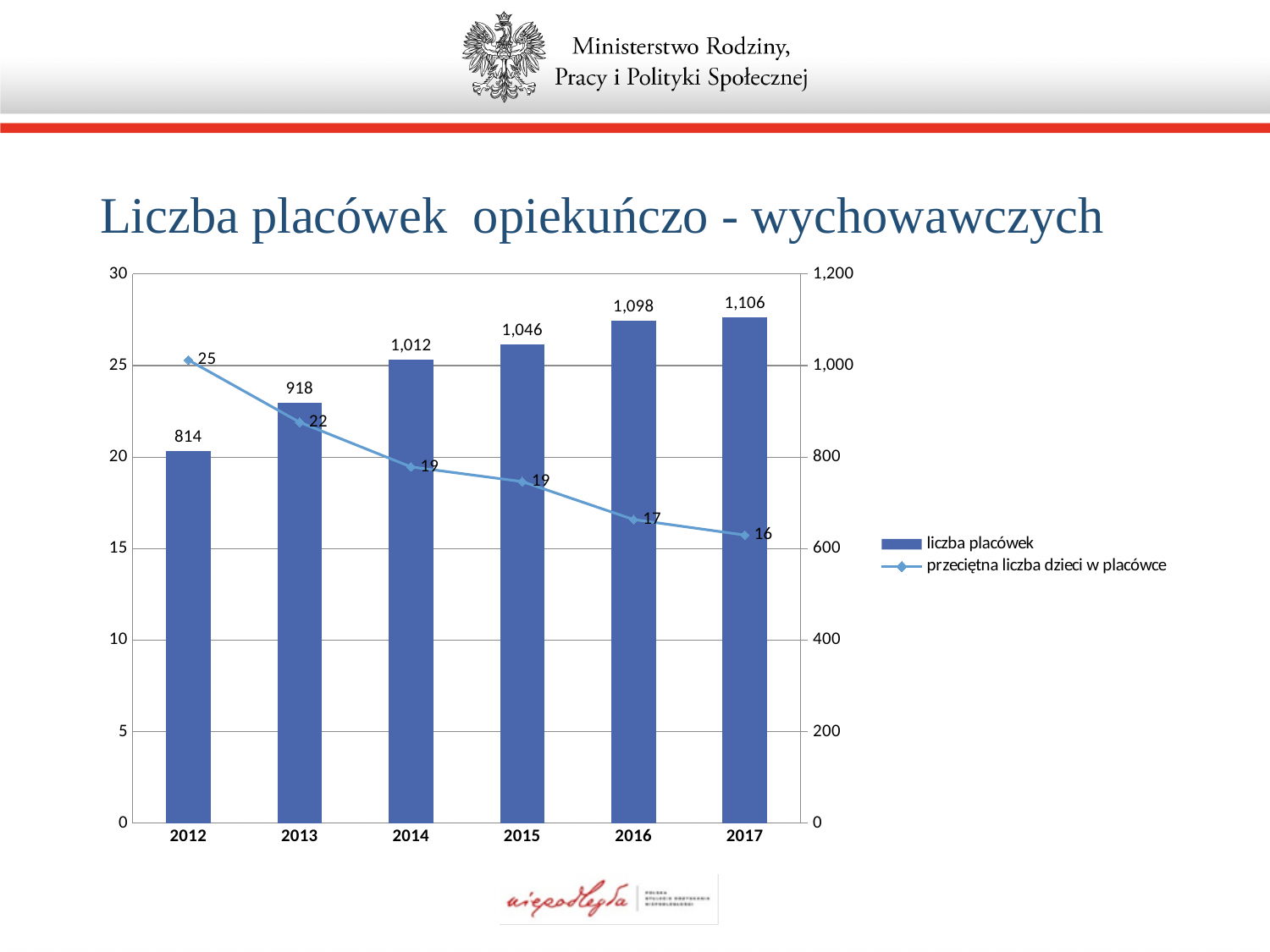
What is the title of the chart? Liczba placówek opiekuńczo - wychowawczych How many series does the legend list? 2 What is the difference in 'liczba placówek' between 2017 and 2012? 292 Which is larger, 'liczba placówek' in 2014 or in 2015? 2015 Which year has the lowest value for 'przeciętna liczba dzieci w placówce'? 2017 What is the value of 'liczba placówek' for 2012? 814 How many years are shown on the x axis? 6 Does 'przeciętna liczba dzieci w placówce' rise or fall from 2012 to 2017? fall What is the value of 'liczba placówek' for 2017? 1,106 Which year has the highest value for 'liczba placówek'? 2017 What is the value of 'przeciętna liczba dzieci w placówce' for 2013? 22 What is the value of 'przeciętna liczba dzieci w placówce' for 2017? 16